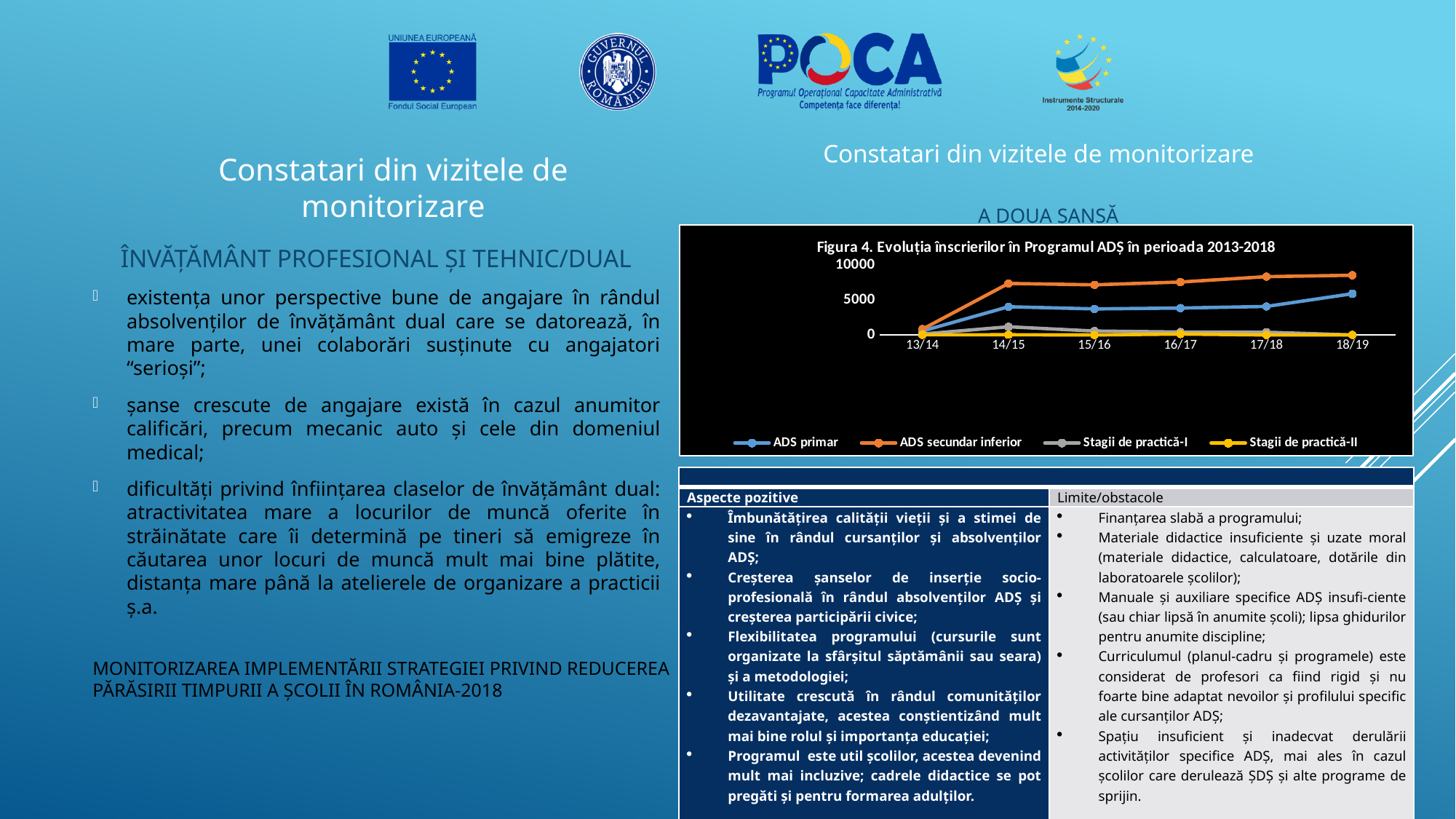
How many series does the chart legend list? 4 Does the value for ADS secundar inferior rise or fall from 13/14 to 18/19? rise Is the value for ADS primar in 14/15 greater or less than 5000? less Which series is drawn in orange in the chart? ADS secundar inferior How many school years are shown on the x axis of the chart? 6 Is the value for ADS secundar inferior in 14/15 greater or less than 5000? greater What kind of chart is shown on the slide? line chart In which school year is the value for ADS secundar inferior lowest? 13/14 What is the title of the chart? Figura 4. Evoluția înscrierilor în Programul ADȘ în perioada 2013-2018 Which series has the highest value in 18/19? ADS secundar inferior Is the value for ADS secundar inferior in 18/19 greater or less than 5000? greater In 16/17, which is larger: ADS primar or Stagii de practică-I? ADS primar